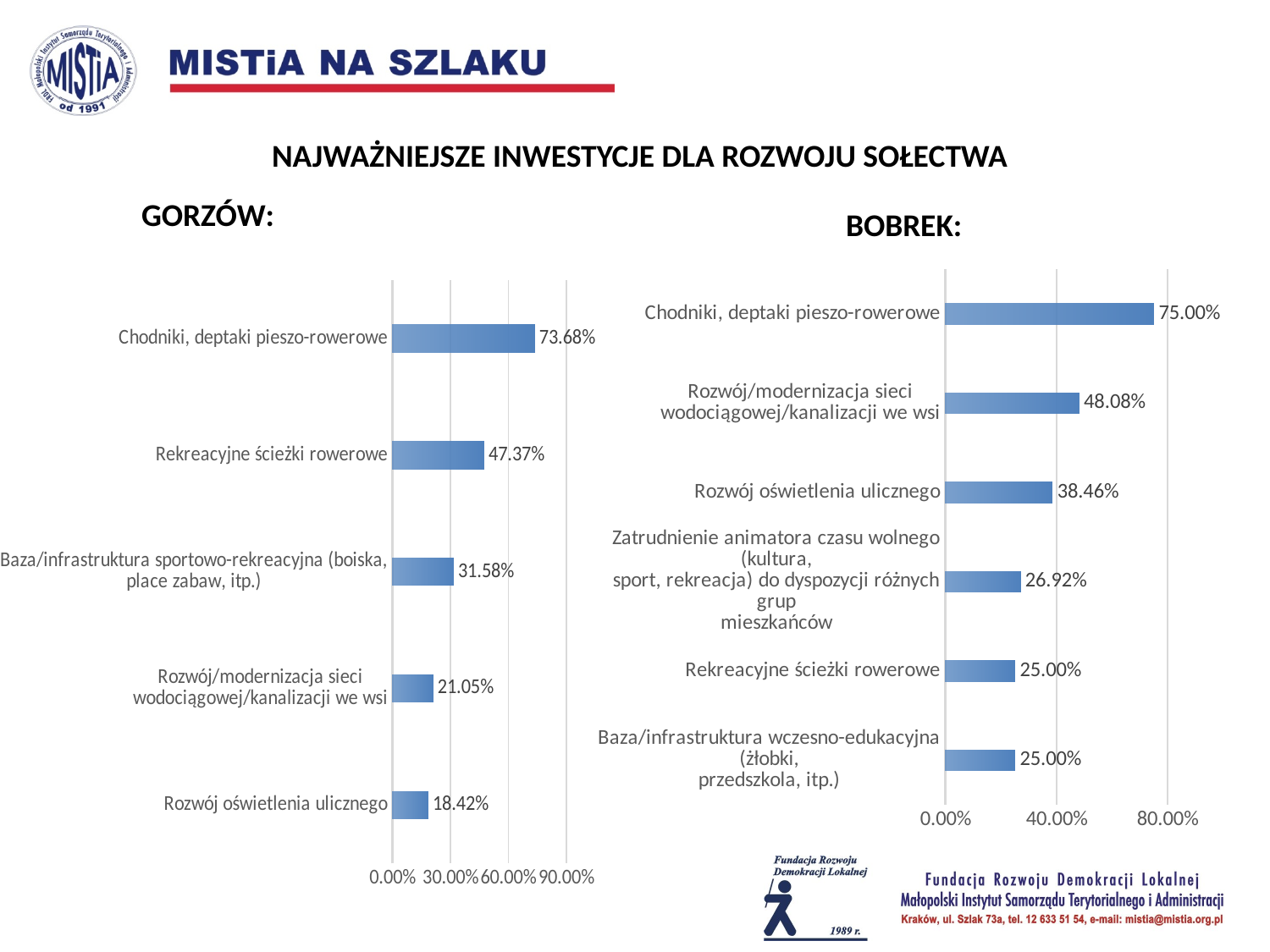
In the BOBREK chart, which category has the highest value? Chodniki, deptaki pieszo-rowerowe In the BOBREK chart, what is the value for Rozwój oświetlenia ulicznego? 38.46% In the GORZÓW chart, what is the value for Chodniki, deptaki pieszo-rowerowe? 73.68% In the GORZÓW chart, is the value for Baza/infrastruktura sportowo-rekreacyjna (boiska, place zabaw, itp.) greater or less than 30.00%? greater How many categories does the BOBREK chart show? 6 In the GORZÓW chart, which category has the lowest value? Rozwój oświetlenia ulicznego In the BOBREK chart, what is the difference between Chodniki, deptaki pieszo-rowerowe and Rozwój/modernizacja sieci wodociągowej/kanalizacji we wsi? 26.92% How many categories does the GORZÓW chart show? 5 Which is larger: Rekreacyjne ścieżki rowerowe in the GORZÓW chart or Rekreacyjne ścieżki rowerowe in the BOBREK chart? GORZÓW In the GORZÓW chart, what is the difference between Rekreacyjne ścieżki rowerowe and Rozwój/modernizacja sieci wodociągowej/kanalizacji we wsi? 26.32% What kind of chart is the BOBREK chart? bar chart What is the title shown above both charts on the slide? NAJWAŻNIEJSZE INWESTYCJE DLA ROZWOJU SOŁECTWA